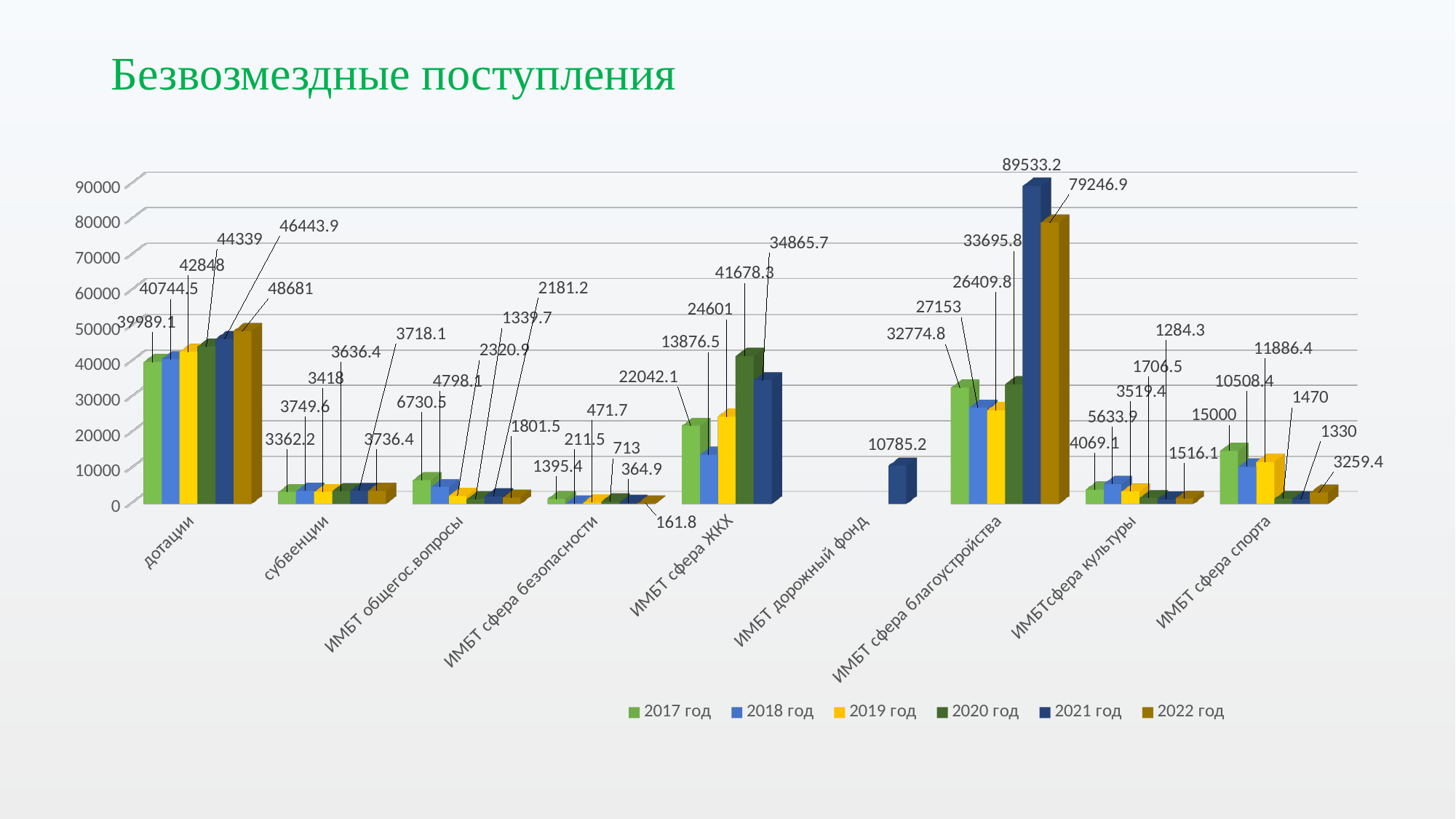
What kind of chart is shown on the slide? Bar chart What is the difference between the 2022 год and 2017 год values for дотации? 8691.9 What is the value for ИМБТ сфера спорта in 2017 год? 15000 How many categories are shown on the x axis? 9 What is the value for дотации in 2022 год? 48681 What is the value shown for ИМБТ дорожный фонд? 10785.2 How many series does the legend list? 6 Which category and year has the highest value on the chart? ИМБТ сфера благоустройства, 2021 год (89533.2) For ИМБТ сфера ЖКХ, which is larger: the 2020 год value or the 2021 год value? 2020 год (41678.3) Do the values for дотации rise or fall from 2017 год to 2022 год? Rise What is the title of the chart? Безвозмездные поступления Which year has the lowest value for ИМБТ сфера безопасности? 2022 год (161.8)